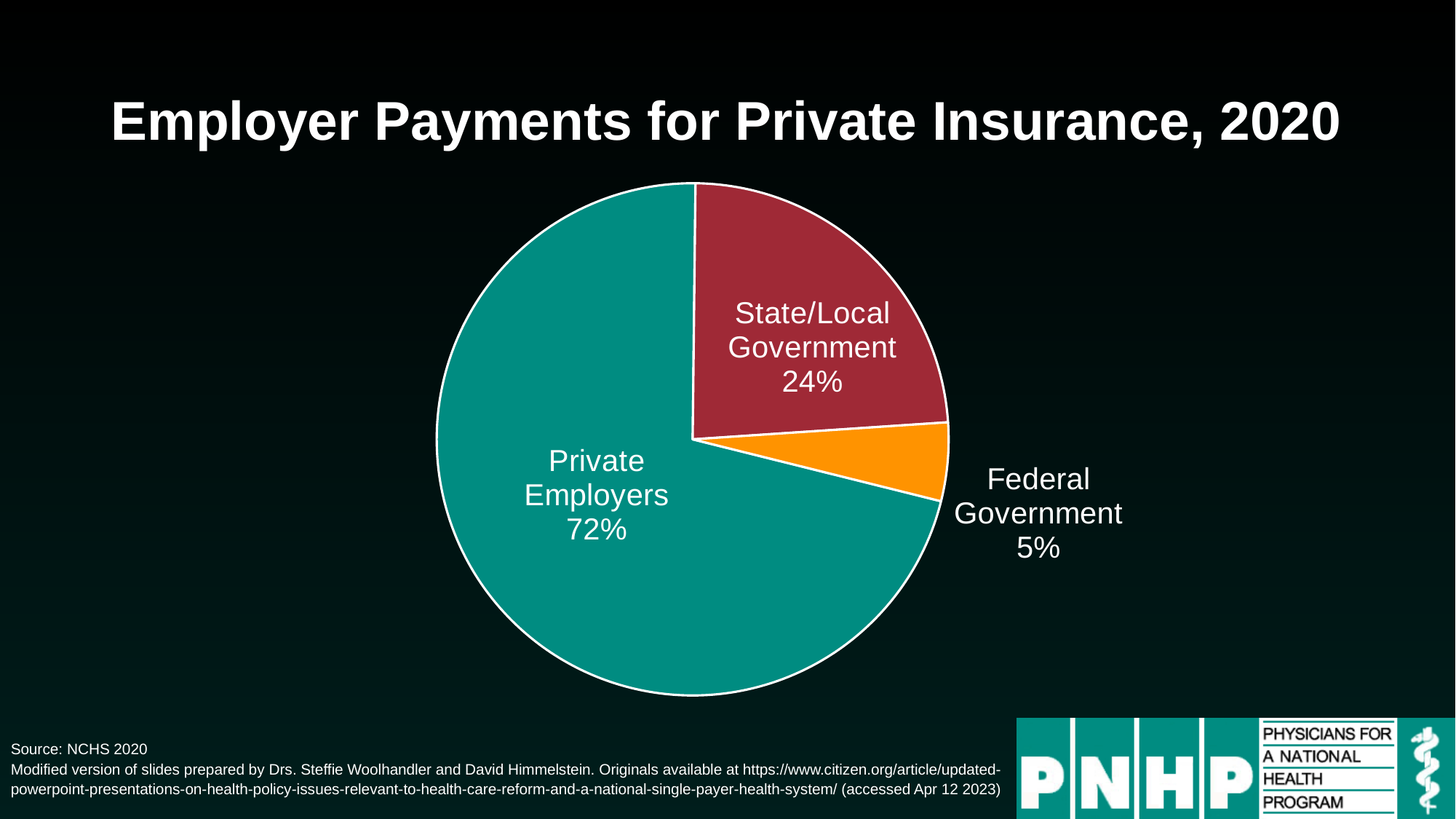
What colour is the Federal Government slice? Orange What share of employer payments for private insurance came from State/Local Government? 24% What is the difference in percentage points between the State/Local Government share and the Federal Government share? 19 Which category accounts for the smallest share of the pie? Federal Government What share of employer payments for private insurance came from Private Employers? 72% Which is larger, the State/Local Government share or the Federal Government share? State/Local Government What kind of chart is shown on the slide? Pie chart What share of employer payments for private insurance came from the Federal Government? 5% What is the title of the chart? Employer Payments for Private Insurance, 2020 How many percentage points larger is the Private Employers share than the State/Local Government share? 48 Which category accounts for the largest share of the pie? Private Employers How many categories are shown in the pie chart? 3